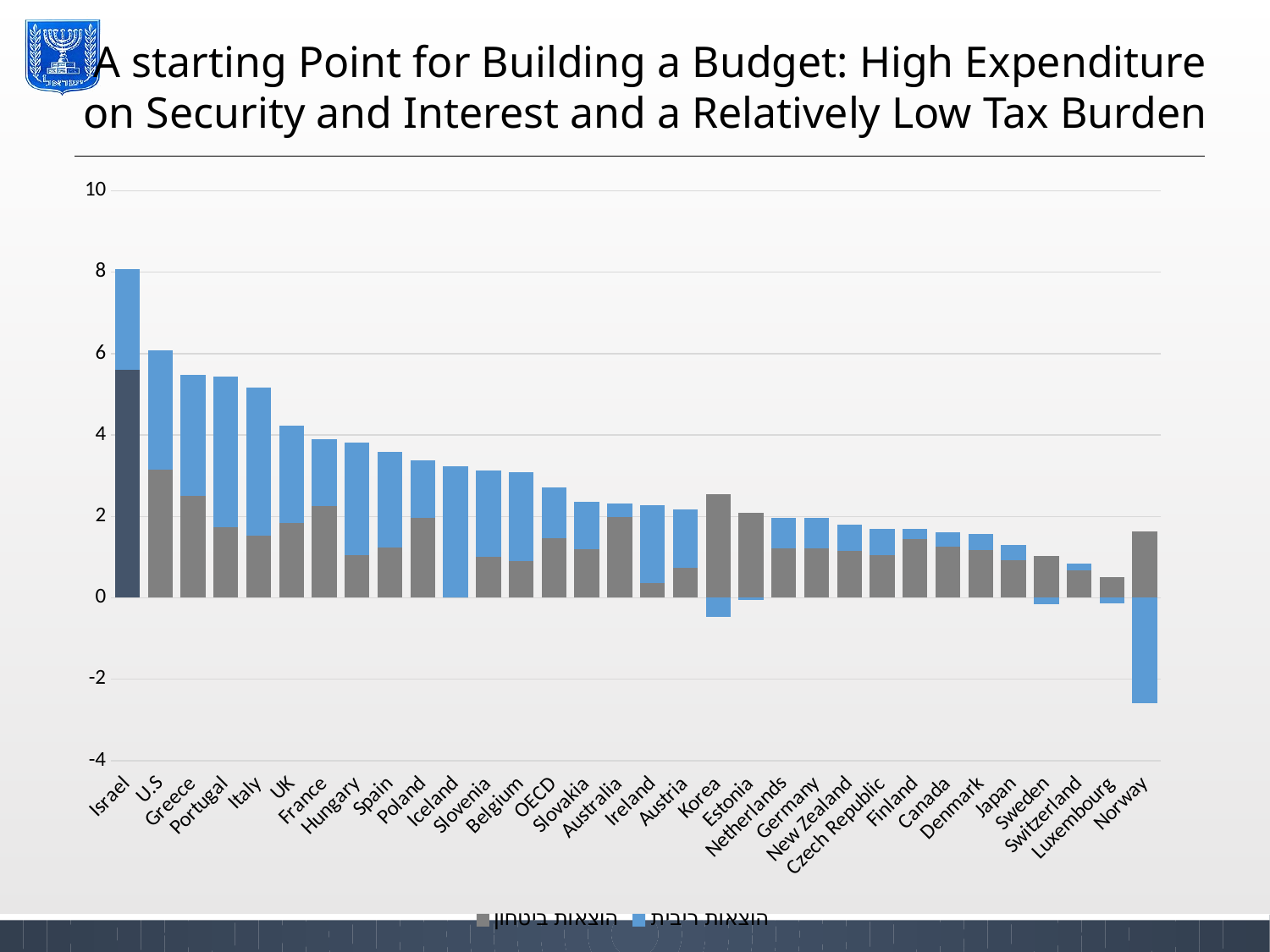
How many series does the chart's legend list? 2 Which category is listed first on the x axis of the chart? Israel Is the total height of the bar for Greece greater or less than 4? greater Is the gray segment for Korea greater or less than 2? greater Which category has the tallest stacked bar in the chart? Israel Is the blue segment for Norway greater or less than -2? less Which has the taller stacked bar, Italy or UK? Italy Do the stacked bar totals generally rise or fall moving from left to right along the x axis? fall What kind of chart is shown on the slide? Stacked bar chart How many countries/categories are shown along the x axis of the chart? 32 Which category has the lowest (most negative) blue segment in the chart? Norway